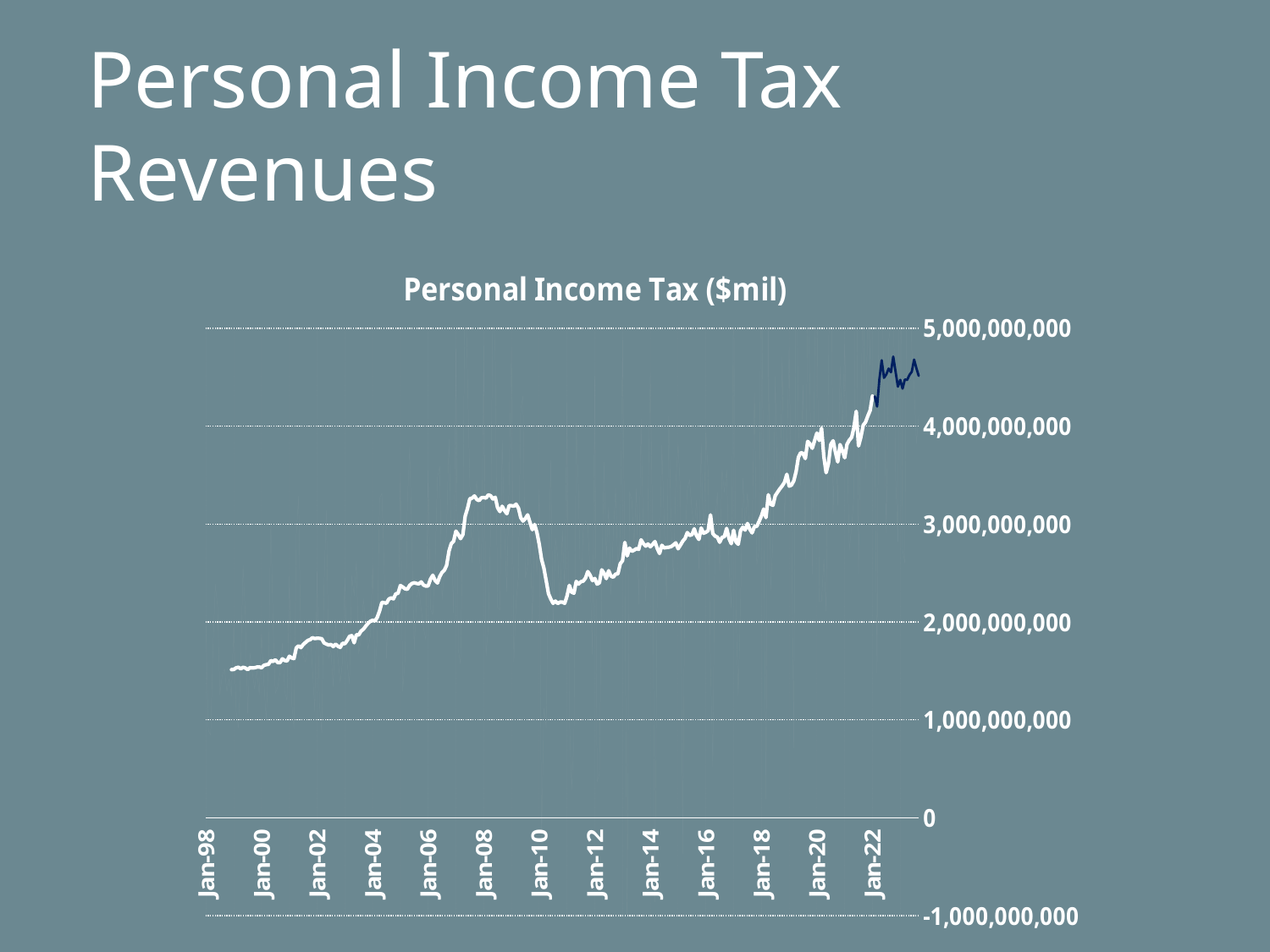
What kind of chart is shown on the slide? line chart Is the value at Jan-98 greater or less than 2,000,000,000? less Is the value at Jan-14 greater or less than 2,000,000,000? greater What is the title of the chart? Personal Income Tax ($mil) How many year labels are shown along the horizontal axis? 13 Which is larger, the value at Jan-98 or the value at Jan-22? Jan-22 Is the value at Jan-06 greater or less than 3,000,000,000? less Overall, do the values rise or fall from Jan-98 to Jan-22? rise Which is larger, the value at Jan-08 or the value at Jan-12? Jan-08 What is the highest value labelled on the vertical axis? 5,000,000,000